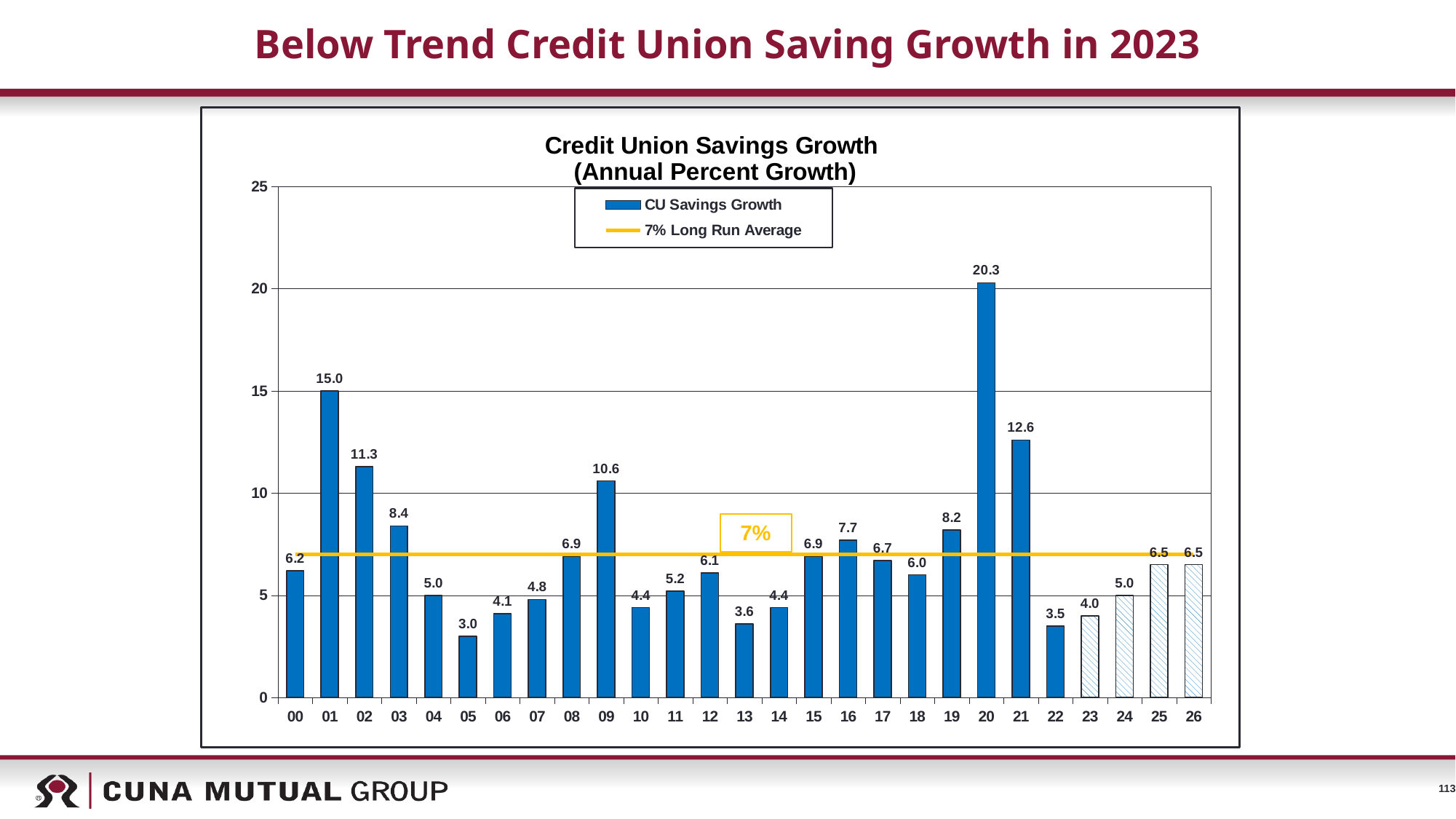
What is the CU Savings Growth value for 20? 20.3 What kind of chart is shown? bar chart What is the difference between the CU Savings Growth values for 20 and 21? 7.7 How many years are shown on the x axis? 27 What is the CU Savings Growth value for 23? 4.0 Which year has the highest CU Savings Growth? 20 How many entries does the legend list? 2 What is the CU Savings Growth value for 09? 10.6 Do the CU Savings Growth values rise or fall from 22 to 26? rise Which is larger, the CU Savings Growth value for 01 or for 02? 01 Which year has the lowest CU Savings Growth? 05 What value does the yellow horizontal line represent? 7% Long Run Average